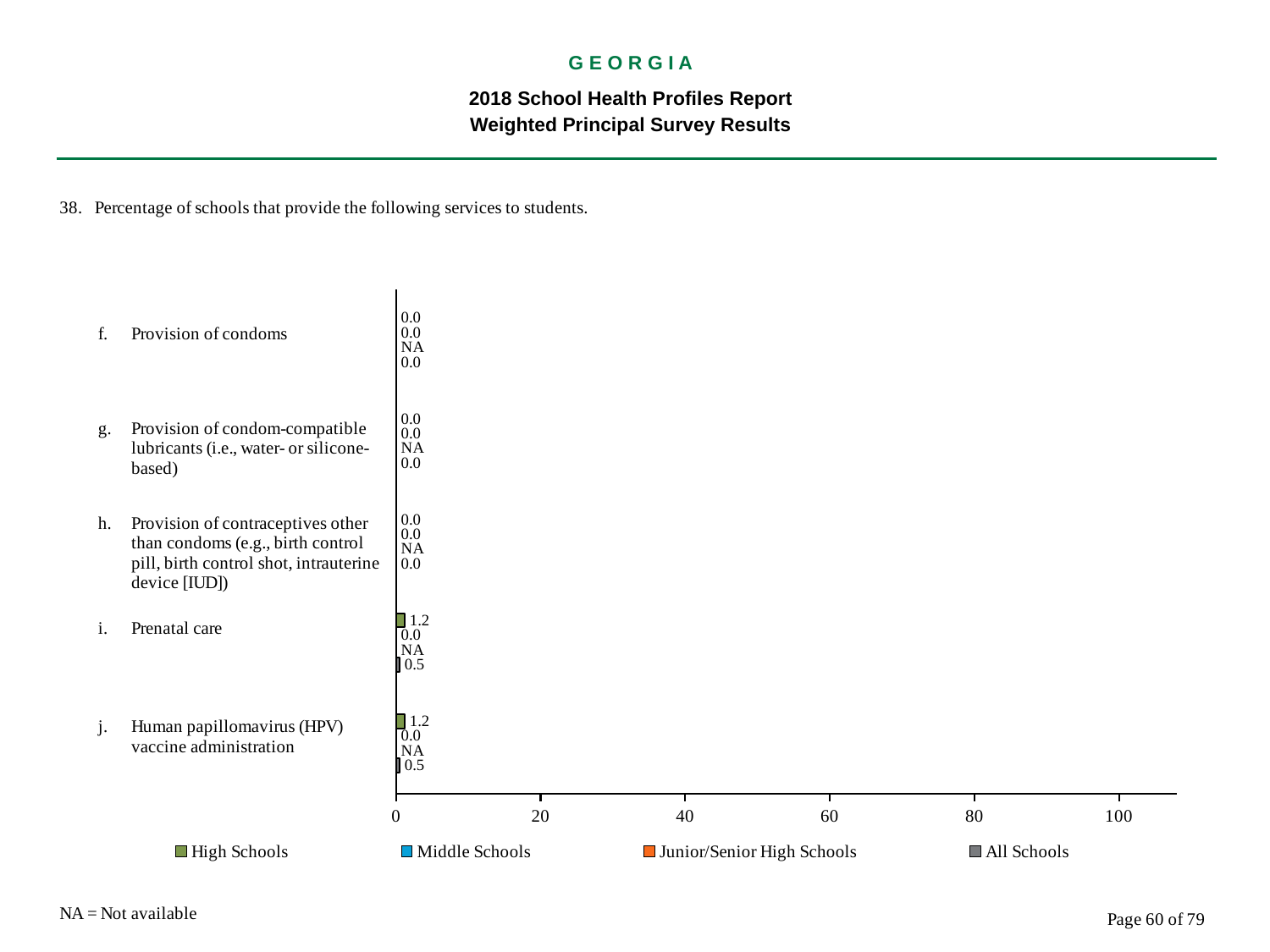
What does NA stand for according to the note on the slide? Not available How many service categories are plotted on the chart? 5 What is shown for Junior/Senior High Schools for Provision of condoms? NA What is the value for Middle Schools for Prenatal care? 0.0 What type of chart is shown on the slide? bar chart What is the value for High Schools for Prenatal care? 1.2 How many series does the legend list? 4 What is the value for High Schools for Provision of contraceptives other than condoms? 0.0 Is the value for High Schools for Prenatal care greater or less than 20? less Which is larger for Human papillomavirus (HPV) vaccine administration: the High Schools value or the All Schools value? High Schools What is the difference between the High Schools value and the All Schools value for Prenatal care? 0.7 What is the value for All Schools for Human papillomavirus (HPV) vaccine administration? 0.5